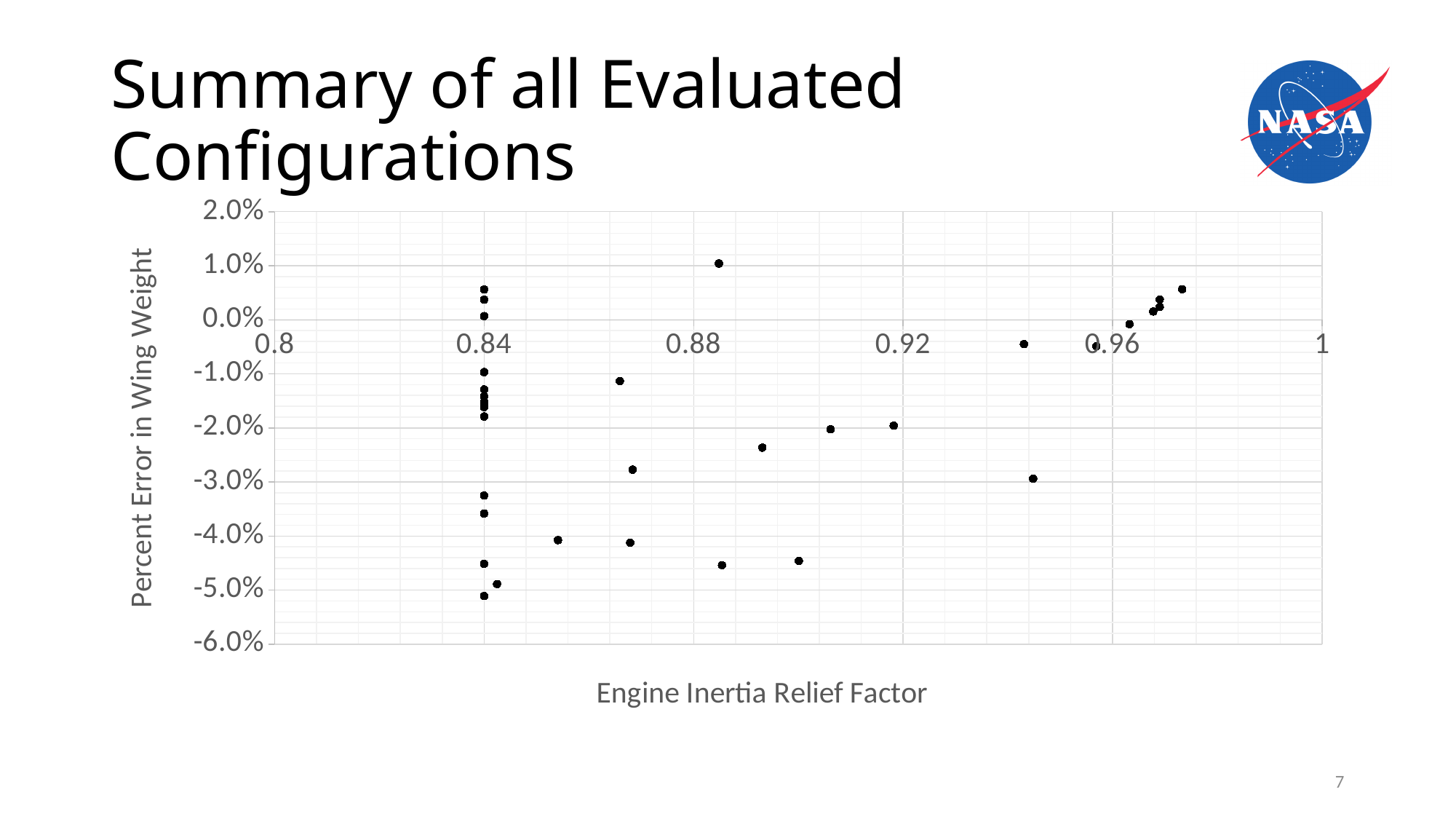
Is the y value of the point with the largest Engine Inertia Relief Factor (near 0.975) greater or less than 0.0%? greater Is the y value of the point near an Engine Inertia Relief Factor of 0.893 greater or less than -2.0%? less What is the title of the x axis of the chart? Engine Inertia Relief Factor Among the points with an Engine Inertia Relief Factor greater than 0.96, do the y values rise or fall as the x value increases? rise Is the y value of the lowest point on the chart greater or less than -4.0%? less What is the title of the y axis of the chart? Percent Error in Wing Weight Which has the higher y value: the highest point near x = 0.885 or the highest point near x = 0.975? The point near x = 0.885 What kind of chart is shown on the slide? Scatter chart Which has the lower y value: the lowest point at x = 0.84 or the point near x = 0.943 at about -3.0%? The lowest point at x = 0.84